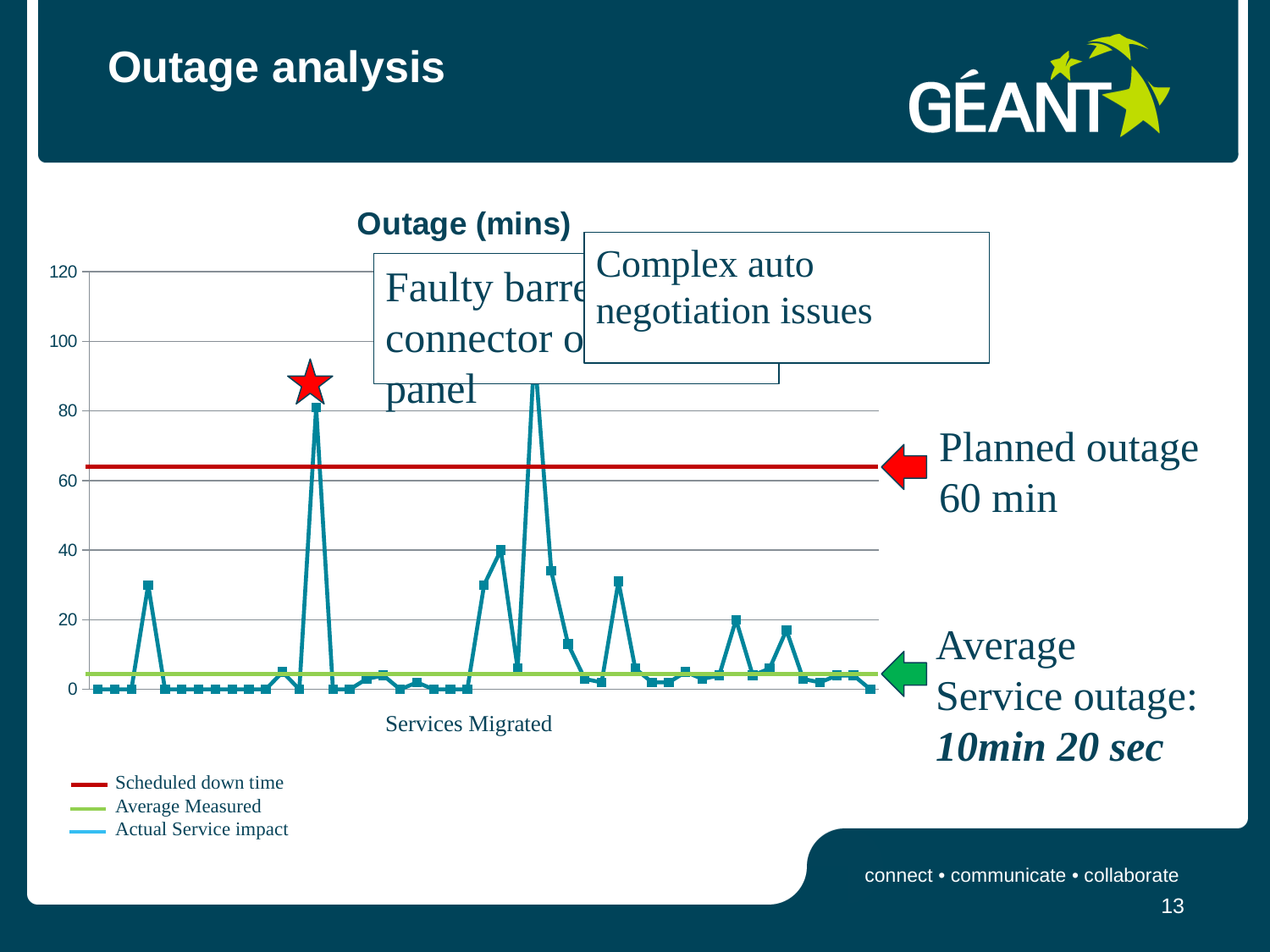
What kind of chart is shown on the slide? line chart Is the value of the Scheduled down time line greater or less than 40? greater Is the value of the Scheduled down time line greater or less than 100? less What is the title of the chart? Outage (mins) Is the value of the Average Measured line greater or less than 20? less What is the maximum value shown on the y axis? 120 How many series does the chart legend list? 3 Which series has the highest peak value: Actual Service impact or Average Measured? Actual Service impact What is the label of the x axis? Services Migrated Which line is higher on the chart: Scheduled down time or Average Measured? Scheduled down time